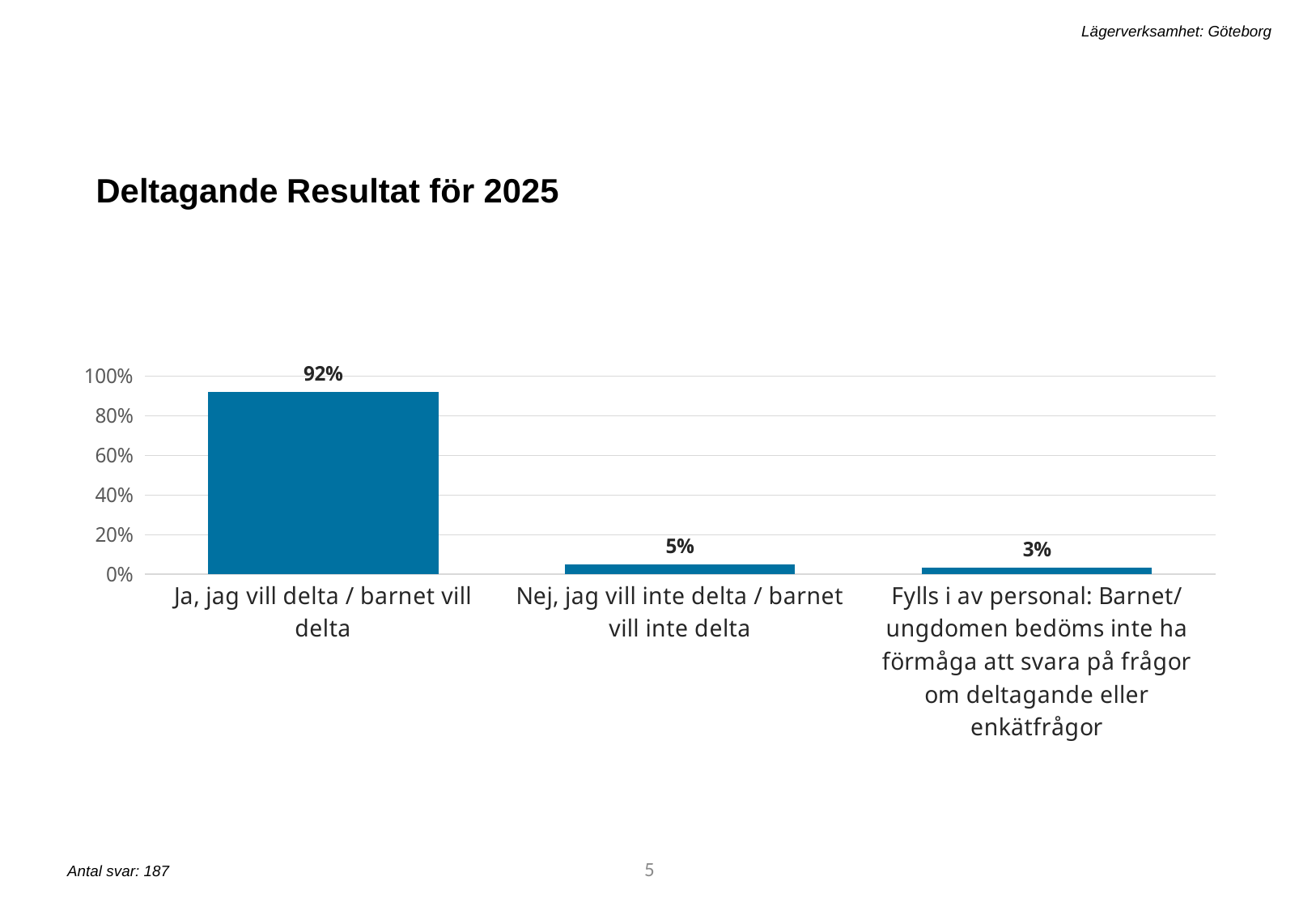
What is the title of the slide containing the chart? Deltagande Resultat för 2025 What is the value for the category filled in by staff ("Fylls i av personal")? 3% Which category has the highest value? Ja, jag vill delta / barnet vill delta What is the value for "Nej, jag vill inte delta / barnet vill inte delta"? 5% Is the value for "Ja, jag vill delta / barnet vill delta" greater or less than 80%? greater What kind of chart is shown on the slide? Bar chart Which category has the lowest value? Fylls i av personal: Barnet/ungdomen bedöms inte ha förmåga att svara på frågor om deltagande eller enkätfrågor What is the difference between the values for "Ja, jag vill delta / barnet vill delta" and "Nej, jag vill inte delta / barnet vill inte delta"? 87% What is the difference between the values for "Nej, jag vill inte delta / barnet vill inte delta" and "Fylls i av personal"? 2% What is the value for "Ja, jag vill delta / barnet vill delta"? 92% How many categories are shown in the chart? 3 Which is larger: the value for "Nej, jag vill inte delta / barnet vill inte delta" or the value for "Fylls i av personal"? Nej, jag vill inte delta / barnet vill inte delta